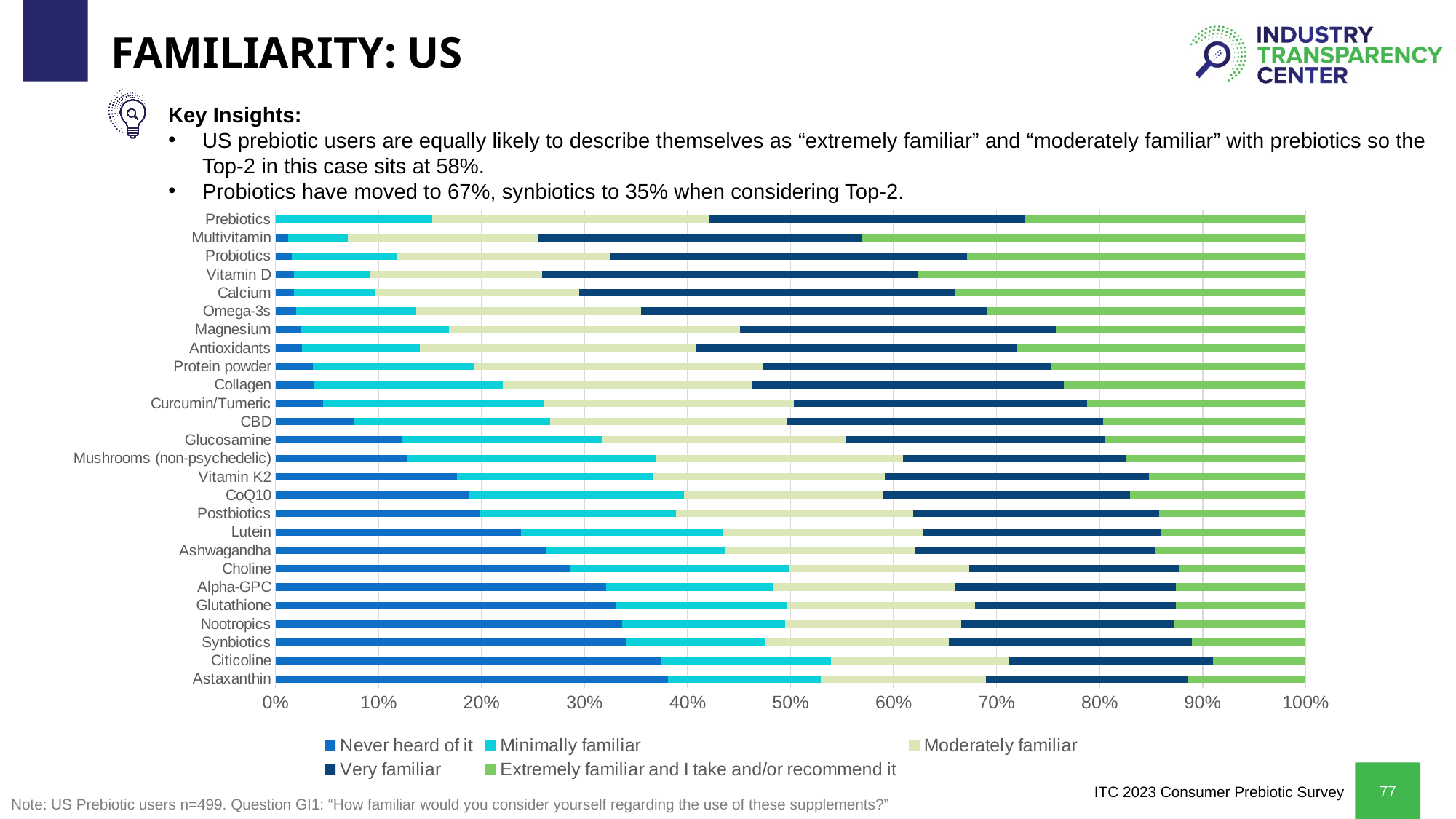
What kind of chart is shown on the slide? Stacked bar chart Which category appears at the top of the chart? Prebiotics Which category has the largest 'Extremely familiar and I take and/or recommend it' segment? Multivitamin What is the highest value shown on the x axis? 100% Moving from the top category (Prebiotics) to the bottom (Astaxanthin), do the 'Never heard of it' segments generally get larger or smaller? larger Is the 'Never heard of it' value for Astaxanthin greater or less than 30%? greater Is the 'Never heard of it' value for Prebiotics greater or less than 10%? less Is the 'Never heard of it' value for Citicoline greater or less than 30%? greater Which has a larger 'Never heard of it' segment, Choline or Glucosamine? Choline Which has a larger 'Extremely familiar and I take and/or recommend it' segment, Multivitamin or Astaxanthin? Multivitamin How many supplement categories are listed on the chart? 26 How many series does the chart legend list? 5